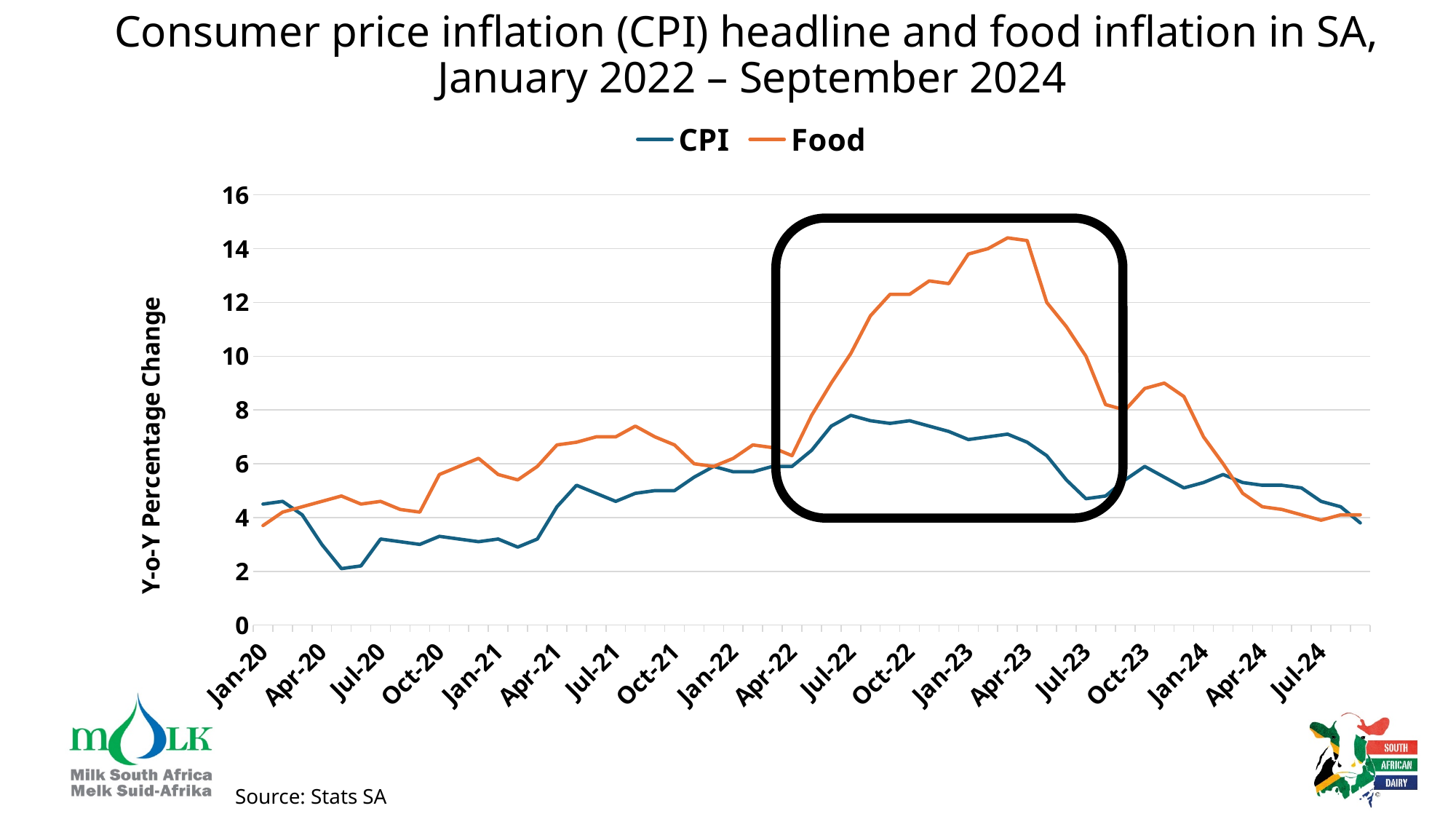
What is the label on the vertical axis? Y-o-Y Percentage Change What are the two series named in the legend? CPI and Food Is the Food value at Jan-23 greater or less than 12? greater At Jan-20, which series has the larger value, CPI or Food? CPI Which series reaches the highest value on the chart? Food What kind of chart is shown on the slide? Line chart Is the CPI value at Jul-22 greater or less than 6? greater At Jan-23, which series has the larger value, CPI or Food? Food How many series does the legend list? 2 Is the Food value at Oct-22 greater or less than 10? greater Does the Food series rise or fall between Apr-22 and Apr-23? Rise